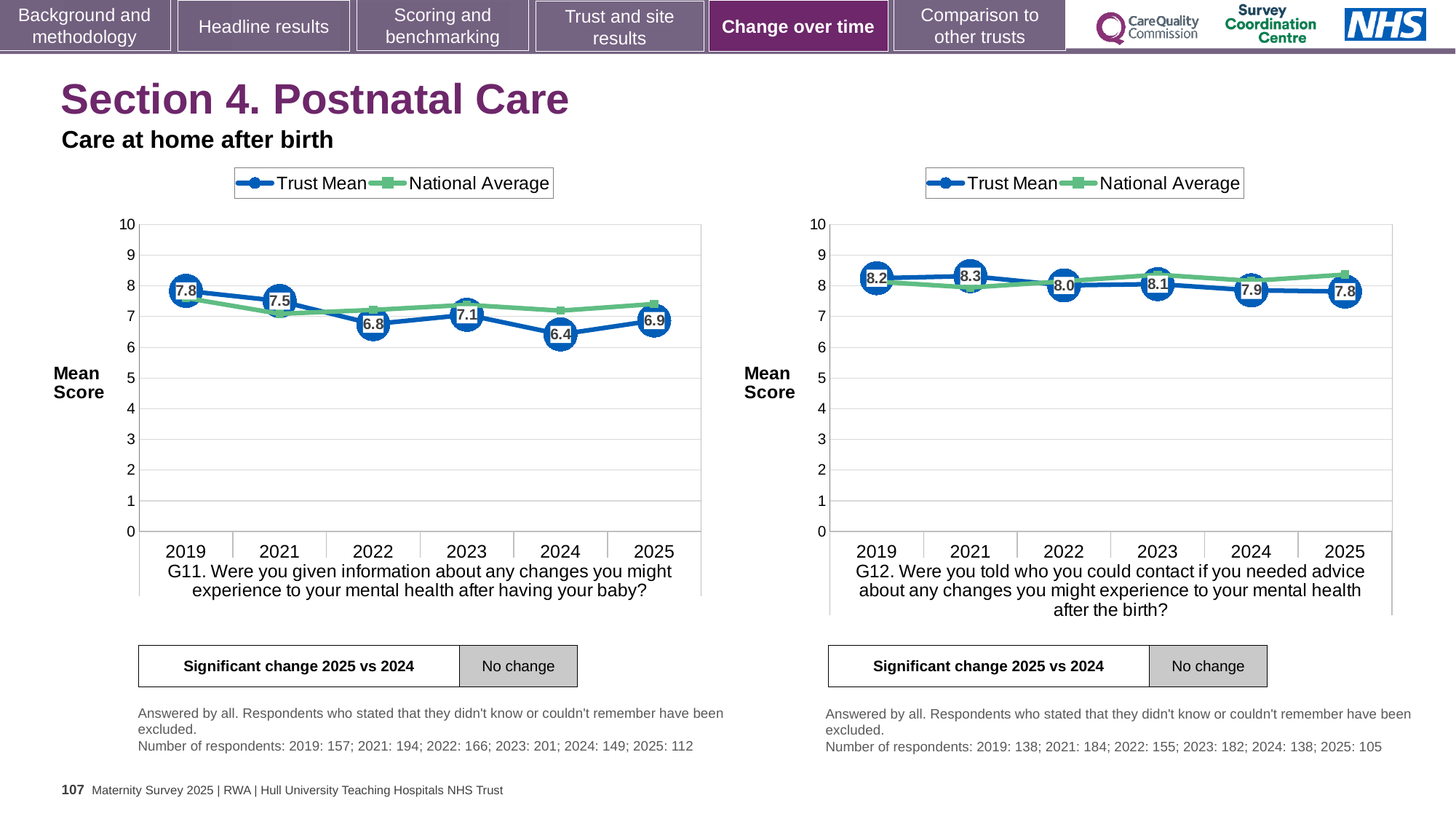
In the G11 chart (left), what is the difference between the Trust Mean scores for 2019 and 2025? 0.9 How many years are plotted on the x axis of the G11 chart (left)? 6 In the G12 chart (right), what is the Trust Mean score for 2021? 8.3 In the G11 chart (left), is the Trust Mean score higher in 2023 or in 2024? 2023 In the G12 chart (right), what is the difference between the Trust Mean scores for 2021 and 2025? 0.5 How many series does the legend of the G12 chart (right) list? 2 In the G12 chart (right), is the National Average for 2025 greater or less than 8? greater In the G12 chart (right), which year has the lowest Trust Mean score? 2025 In the G11 chart (left), which year has the lowest Trust Mean score? 2024 In the G11 chart (left), which year has the highest Trust Mean score? 2019 What type of chart is used for G11 (left)? Line chart In the G11 chart (left), what is the Trust Mean score for 2024? 6.4